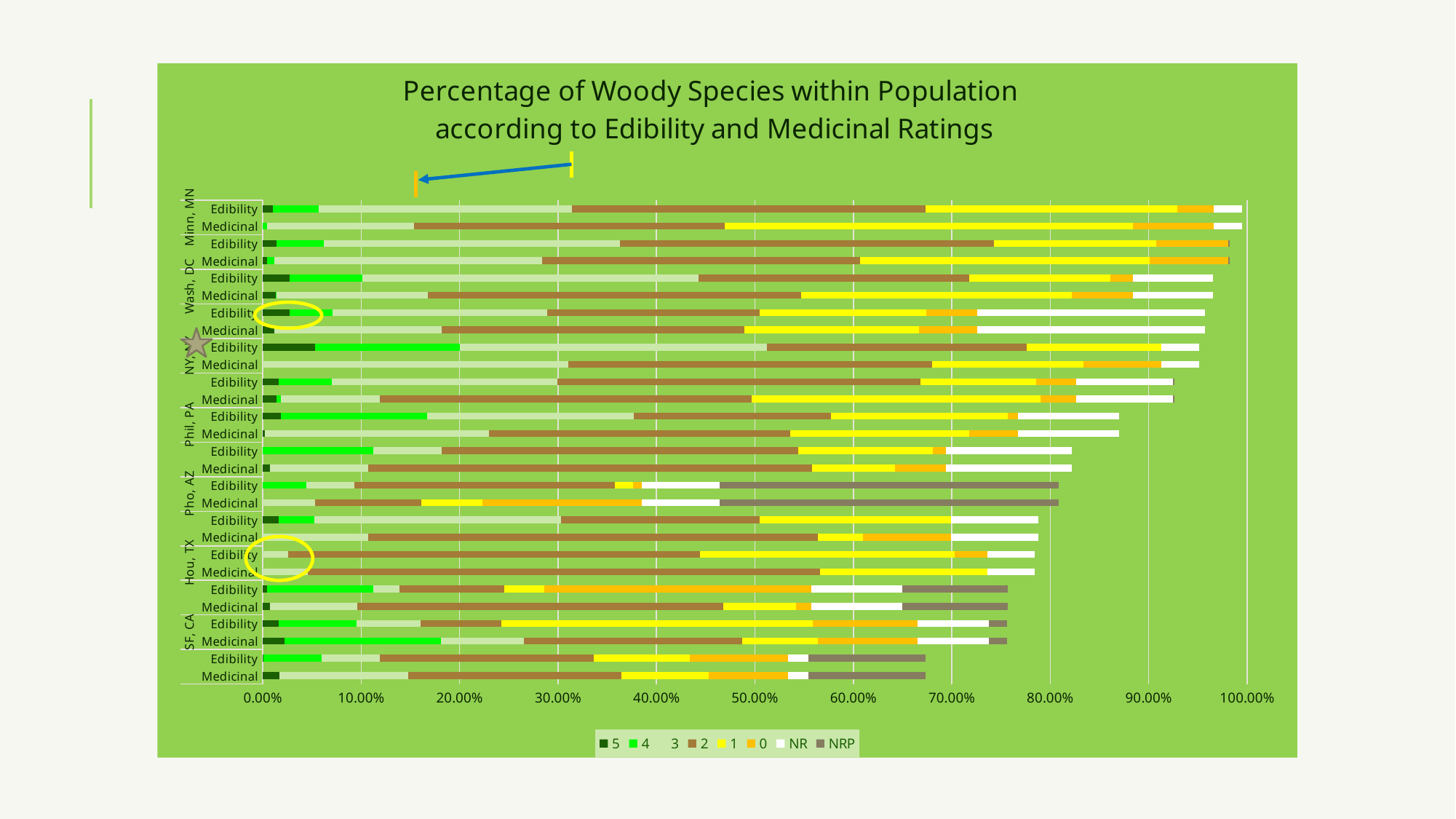
Is the total length of the Wash, DC Edibility bar greater or less than 80%? greater What are the entries listed in the chart legend? 5, 4, 3, 2, 1, 0, NR, NRP Is the total length of the Pho, AZ Medicinal bar greater or less than 70%? greater What is the title of the chart? Percentage of Woody Species within Population according to Edibility and Medicinal Ratings What is the highest value shown on the horizontal axis? 100.00% Which bar is longer in total, the Wash, DC Edibility bar or the Hou, TX Edibility bar? Wash, DC Edibility How many series does the legend list? 8 Which bar is longer in total, the Minn, MN Edibility bar or the Pho, AZ Edibility bar? Minn, MN Edibility Is the total length of the Minn, MN Edibility bar greater or less than 90%? greater What kind of chart is shown on the slide? bar chart How many city labels are shown on the vertical axis? 7